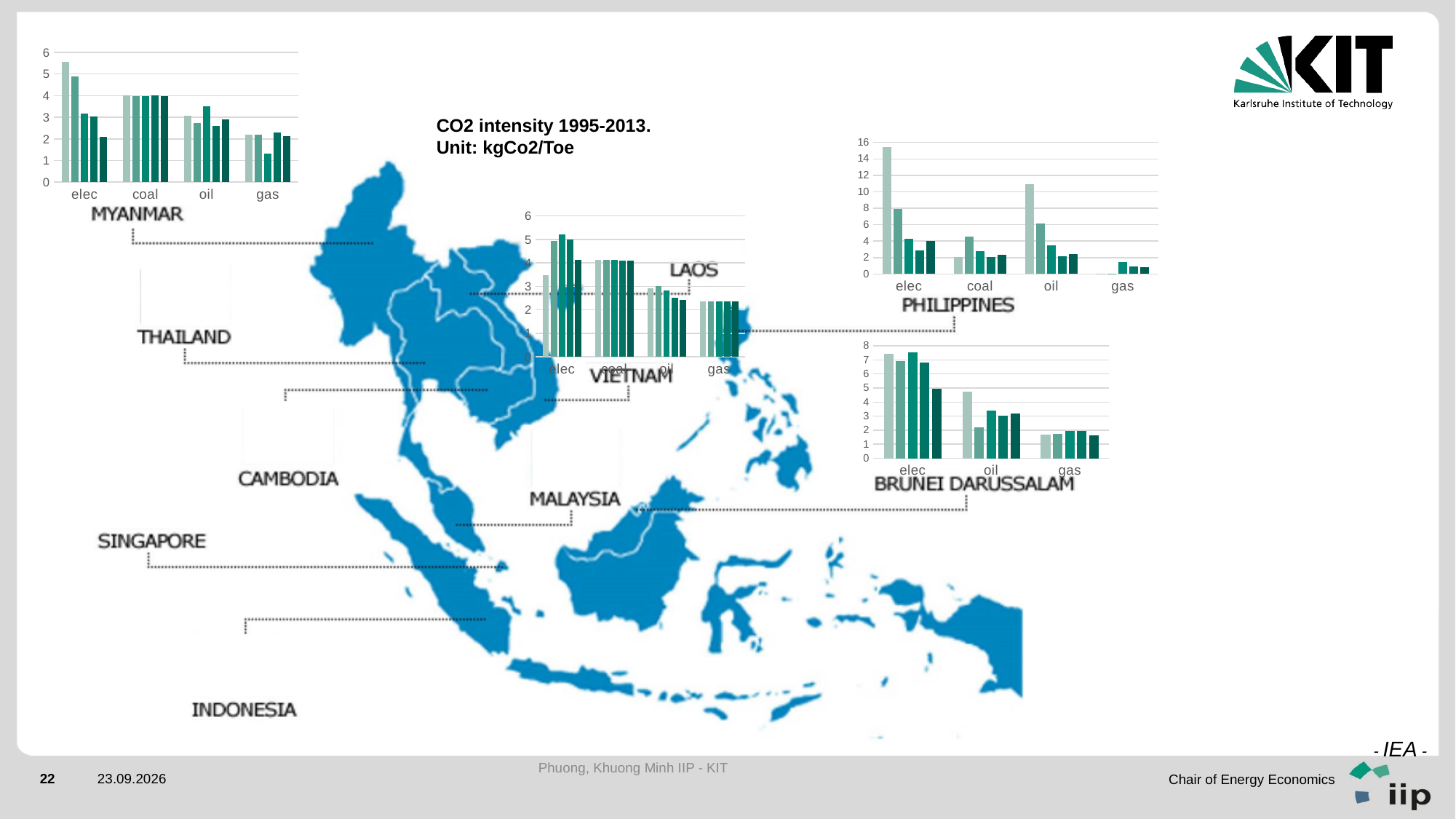
In the PHILIPPINES chart, is the tallest bar for gas greater or less than 2? less In the PHILIPPINES chart, is the tallest bar for elec greater or less than 14? greater How many fuel categories does the PHILIPPINES chart show? 4 In the MYANMAR chart, is the tallest bar for elec greater or less than 5? greater In the BRUNEI DARUSSALAM chart, which category has higher bars, elec or gas? elec What unit is stated for the CO2 intensity charts on the slide? kgCo2/Toe What time period do the CO2 intensity charts cover according to the slide text? 1995-2013 In the PHILIPPINES chart, which category has the tallest bar? elec In the PHILIPPINES chart, which category has the lowest bars? gas How many fuel categories does the BRUNEI DARUSSALAM chart show? 3 What kind of chart is the MYANMAR chart? bar chart